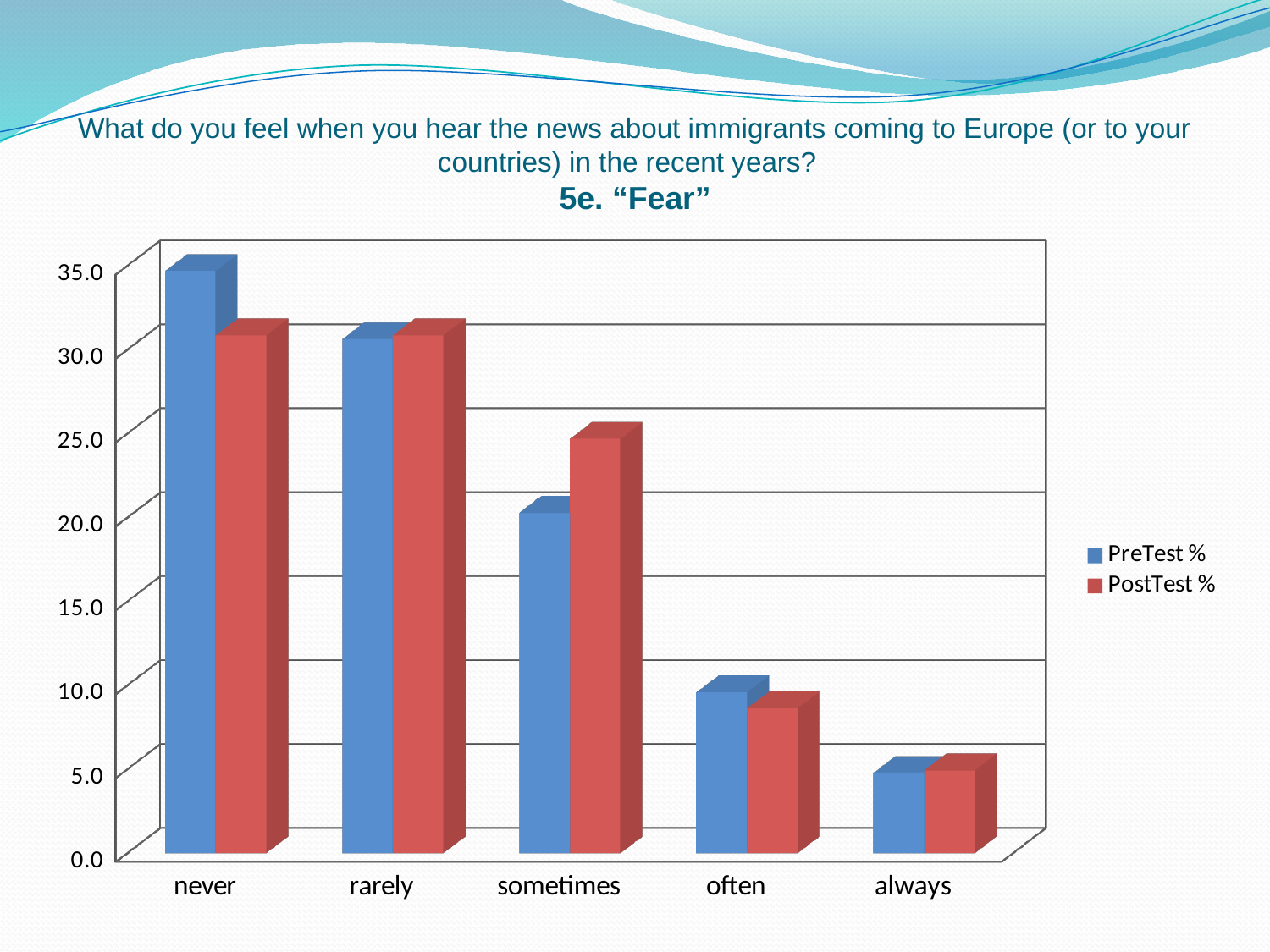
How many categories are shown on the x axis? 5 Is the PreTest % value for 'never' greater or less than 30.0? greater Which category has the lowest PreTest % value? always What colour are the PostTest % bars? red Is the PreTest % value for 'sometimes' greater or less than 25.0? less Which category has the lowest PostTest % value? always Which category has the highest PreTest % value? never What kind of chart is shown on the slide? bar chart For the category 'sometimes', which is larger: PreTest % or PostTest %? PostTest % Do the PreTest % values rise or fall moving from 'never' to 'always' along the x axis? fall How many series does the legend list? 2 For the category 'never', which is larger: PreTest % or PostTest %? PreTest %